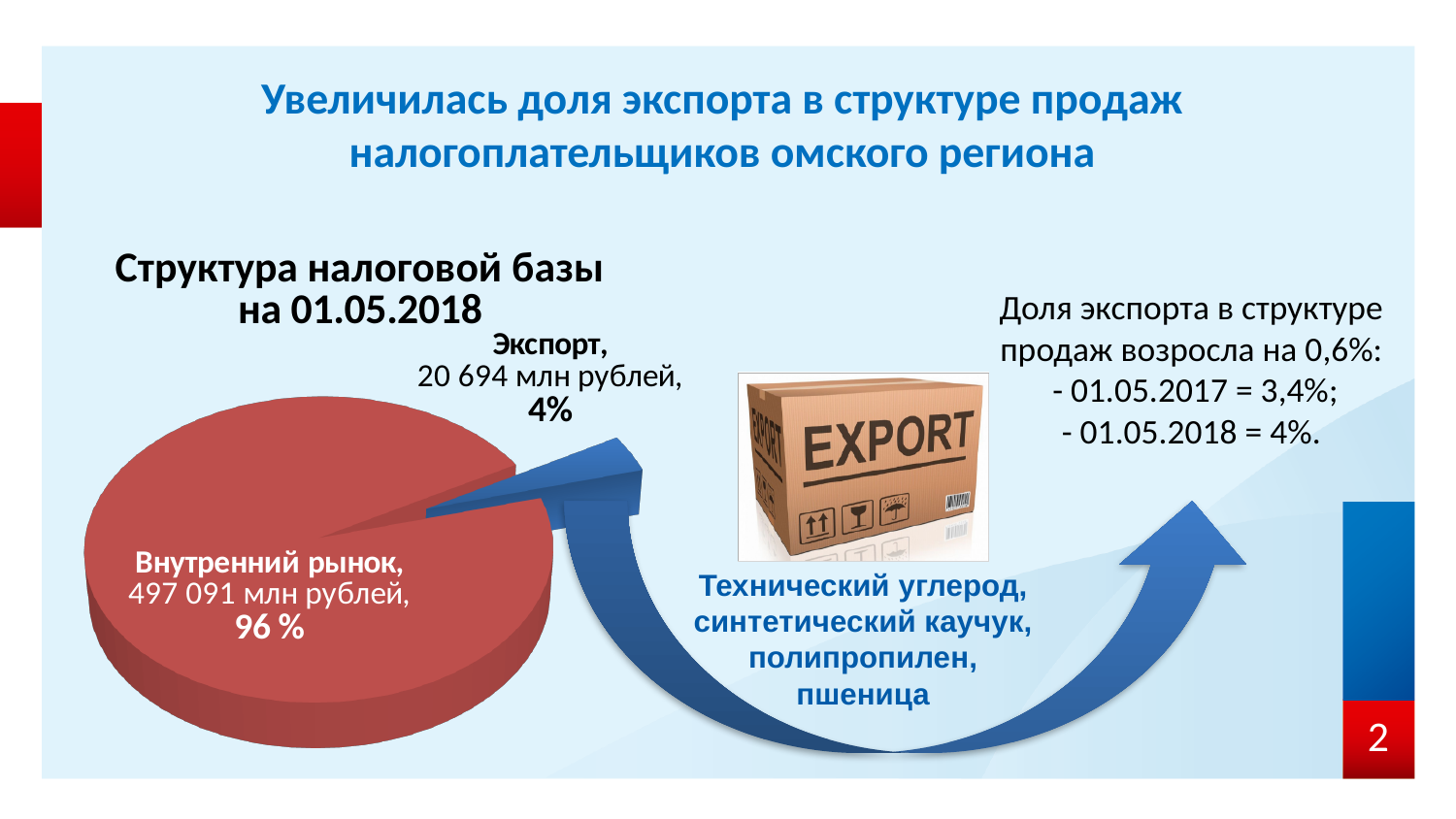
What kind of chart is shown on the slide? pie chart What is the value for Внутренний рынок in the pie chart? 497 091 млн рублей Which slice of the pie chart is the largest? Внутренний рынок Which is larger in the pie chart, Внутренний рынок or Экспорт? Внутренний рынок How many slices does the pie chart have? 2 What is the value for Экспорт in the pie chart? 20 694 млн рублей What is the total of the two slices in the pie chart, in млн рублей? 517 785 млн рублей Which slice of the pie chart is the smallest? Экспорт What share of the pie does Экспорт represent? 4% What share of the pie does Внутренний рынок represent? 96 % What is the title of the pie chart? Структура налоговой базы на 01.05.2018 What is the difference in млн рублей between Внутренний рынок and Экспорт in the pie chart? 476 397 млн рублей